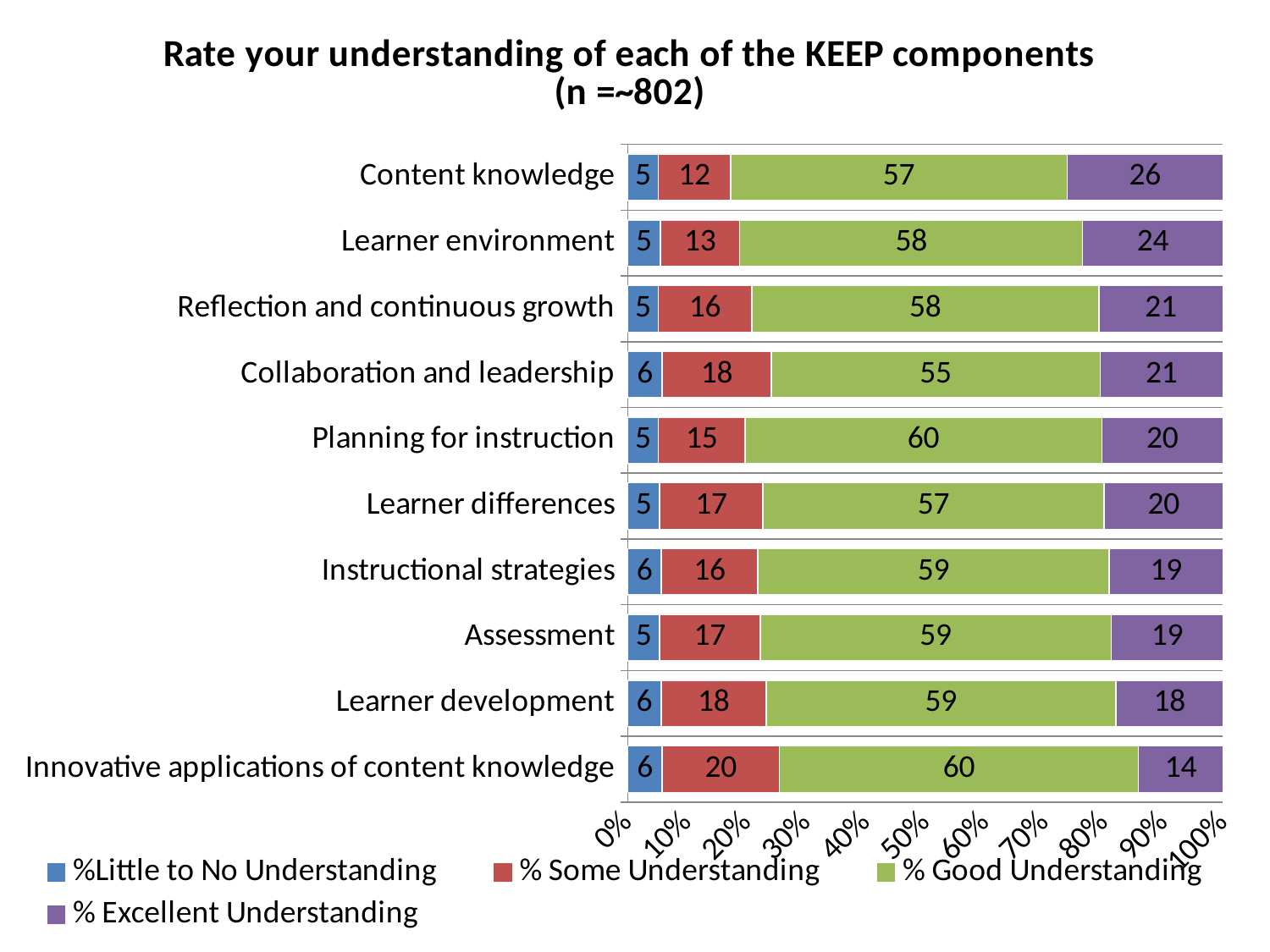
How many series does the legend list? 4 Which component has the highest % Excellent Understanding value? Content knowledge What kind of chart is shown on the slide? Stacked bar chart Which component has the lowest % Some Understanding value? Content knowledge What is the % Some Understanding value for Innovative applications of content knowledge? 20 How many KEEP components are listed on the chart? 10 Which component has the lowest % Excellent Understanding value? Innovative applications of content knowledge What is the % Excellent Understanding value for Content knowledge? 26 Which is larger: the % Good Understanding value for Planning for instruction or for Collaboration and leadership? Planning for instruction What is the % Good Understanding value for Collaboration and leadership? 55 What is the difference between the % Excellent Understanding values for Content knowledge and Innovative applications of content knowledge? 12 What is the total of the stacked bar for Content knowledge? 100